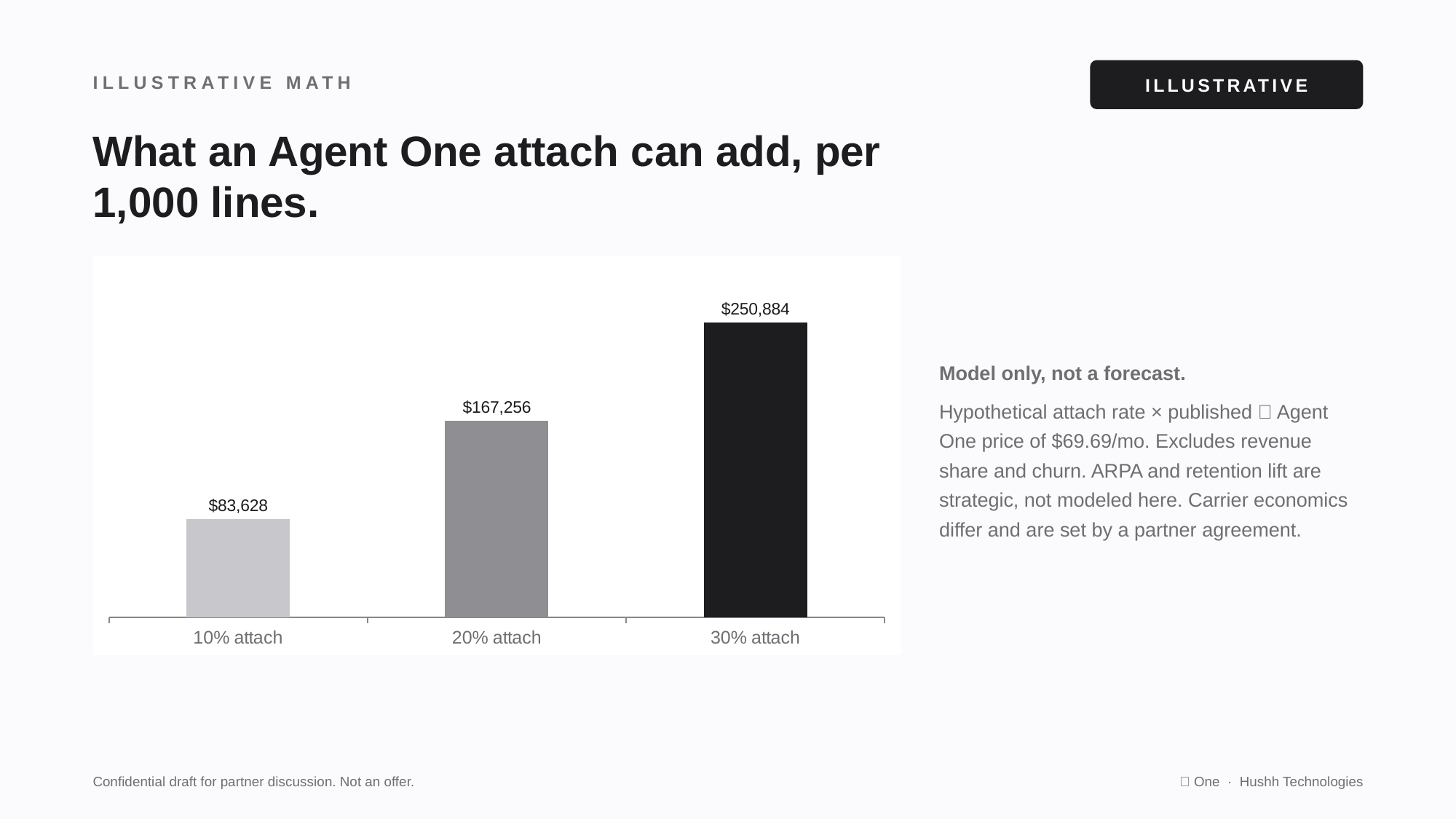
Which category has the highest value? 30% attach What is the difference between the values for 30% attach and 10% attach? $167,256 Do the values rise or fall from left to right along the x axis? Rise What is the difference between the values for 20% attach and 10% attach? $83,628 What is the value for 20% attach? $167,256 Which category has the lowest value? 10% attach Which is larger, the value for 20% attach or the value for 30% attach? 30% attach What kind of chart is shown on the slide? Bar chart What is the value for 10% attach? $83,628 What is the value for 30% attach? $250,884 How many categories are shown in the chart? 3 What colour is the bar for 30% attach? Black